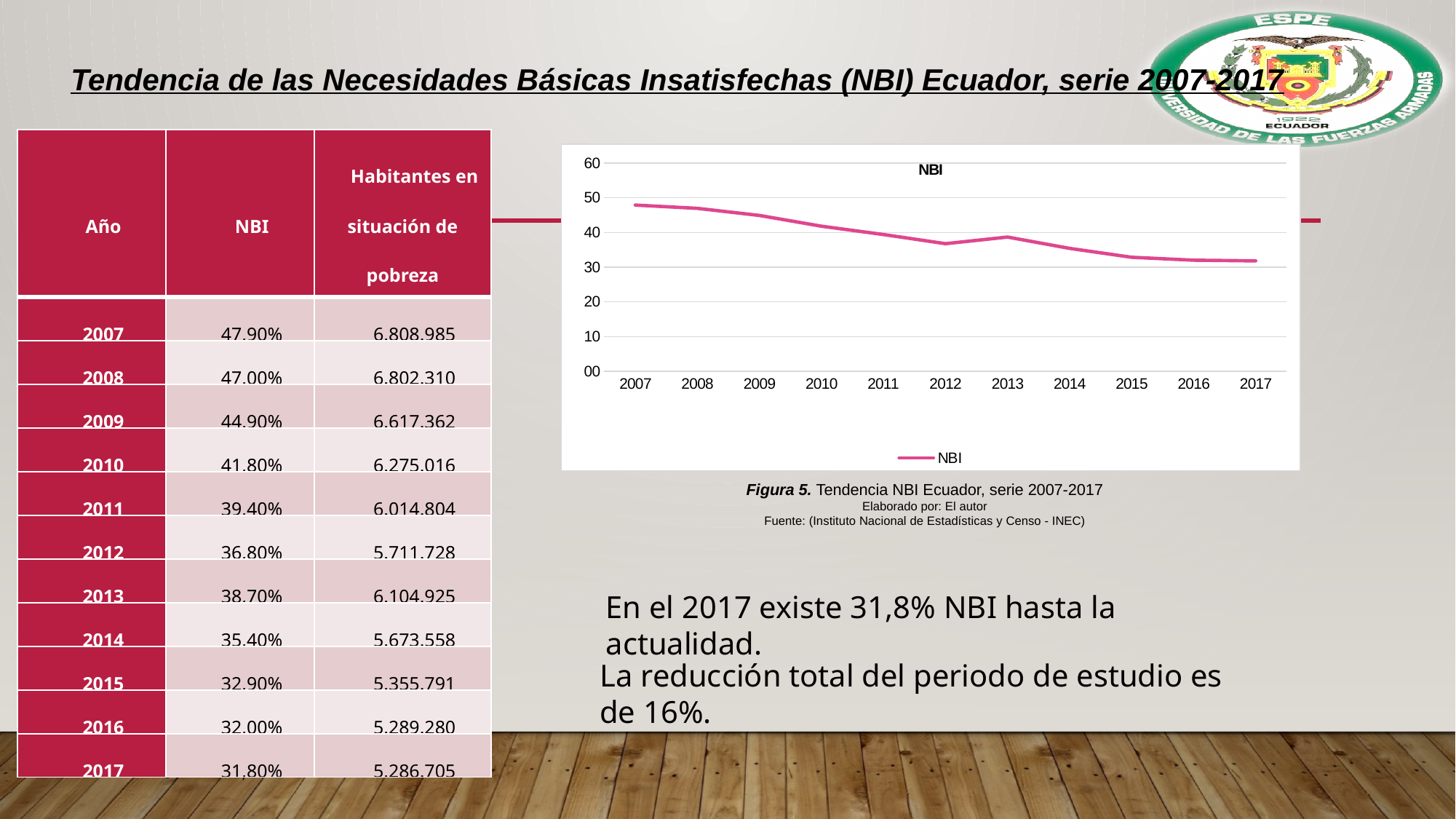
What is the title of the chart? NBI Which year has the higher NBI value, 2007 or 2017? 2007 Is the NBI value for 2012 greater or less than 40? less Is the NBI value for 2017 greater or less than 40? less Is the NBI value for 2007 greater or less than 40? greater Which year has the highest NBI value in the chart? 2007 How many years are plotted along the x axis of the chart? 11 What kind of chart is shown on the slide? line chart How many series does the chart legend list? 1 Overall, does the NBI line rise or fall from 2007 to 2017? fall Which year has the higher NBI value, 2012 or 2013? 2013